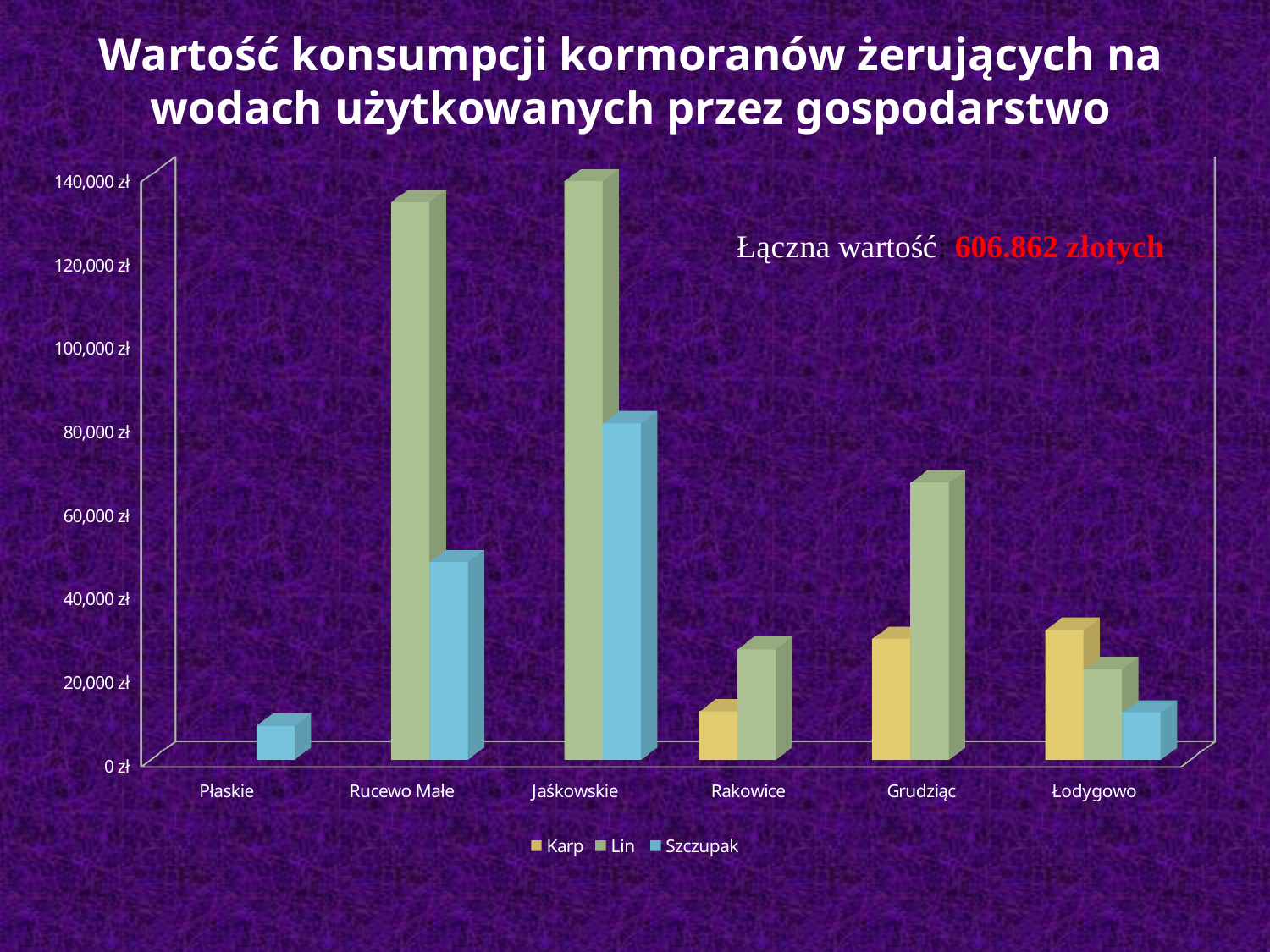
What total value (Łączna wartość) is stated on the slide? 606.862 złotych Is the Szczupak value for Płaskie greater or less than 20,000 zł? less Which category has the highest Lin value? Jaśkowskie Which is larger for Łodygowo, the Karp value or the Szczupak value? Karp How many categories (fish farms) are shown on the x axis? 6 Which category has the highest Szczupak value? Jaśkowskie Is the Lin value for Grudziąc greater or less than 60,000 zł? greater Is the Lin value for Rucewo Małe greater or less than 120,000 zł? greater How many series does the legend list? 3 What kind of chart is shown on the slide? bar chart Which is larger for Rakowice, the Karp value or the Lin value? Lin